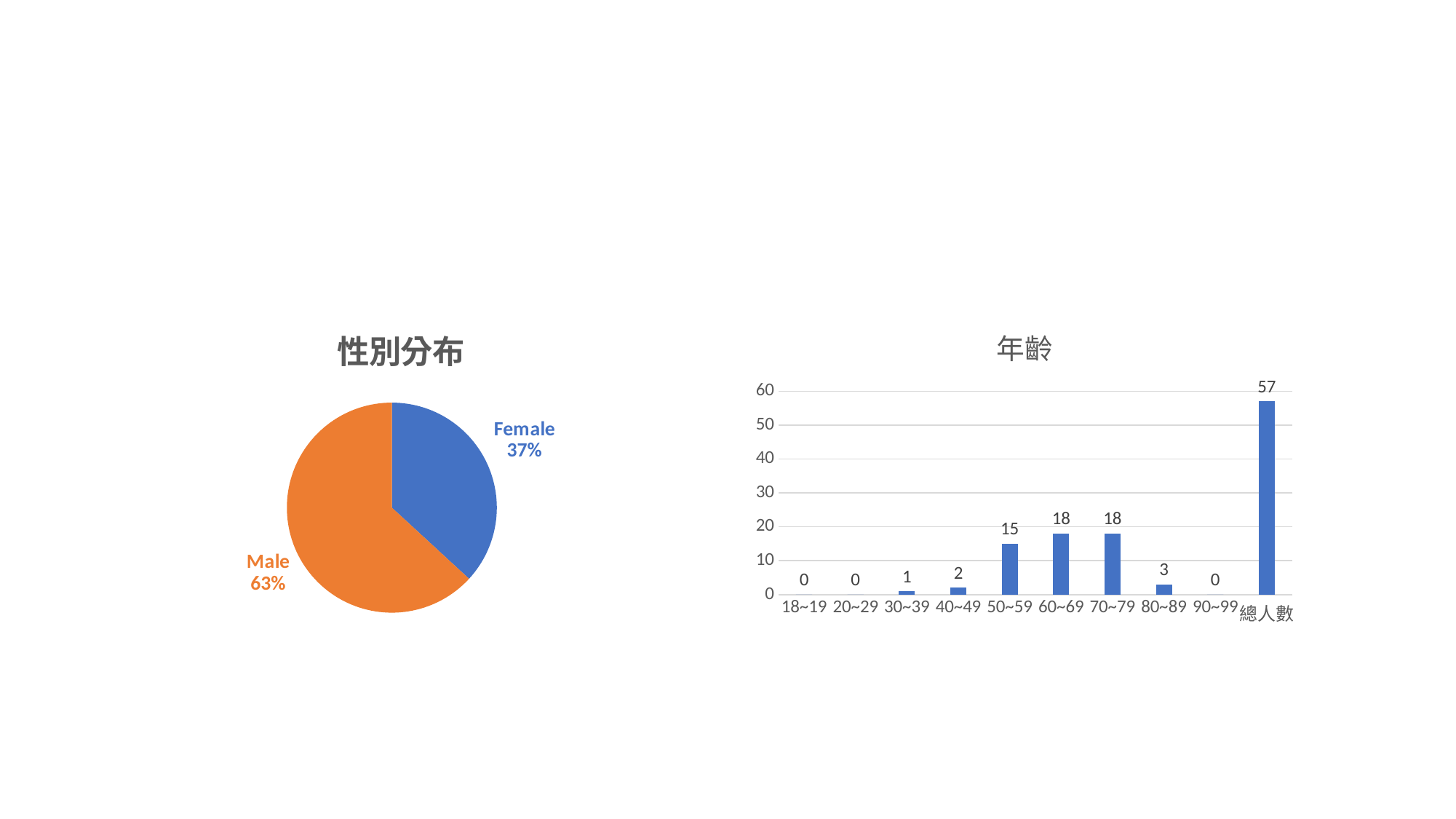
In the 性別分布 chart, which slice is larger, Male or Female? Male What kind of chart is the 年齡 chart? bar chart In the 性別分布 chart, what share of the pie is Male? 63% In the 年齡 chart, what is the value for 80~89? 3 What kind of chart is the 性別分布 chart? pie chart In the 年齡 chart, which is larger, the value for 40~49 or the value for 80~89? 80~89 In the 性別分布 chart, what share of the pie is Female? 37% In the 年齡 chart, what is the value for 總人數? 57 In the 年齡 chart, what is the difference between the values for 60~69 and 50~59? 3 In the 年齡 chart, which category has the highest value? 總人數 How many categories are shown on the x axis of the 年齡 chart? 10 In the 年齡 chart, what is the value for 50~59? 15